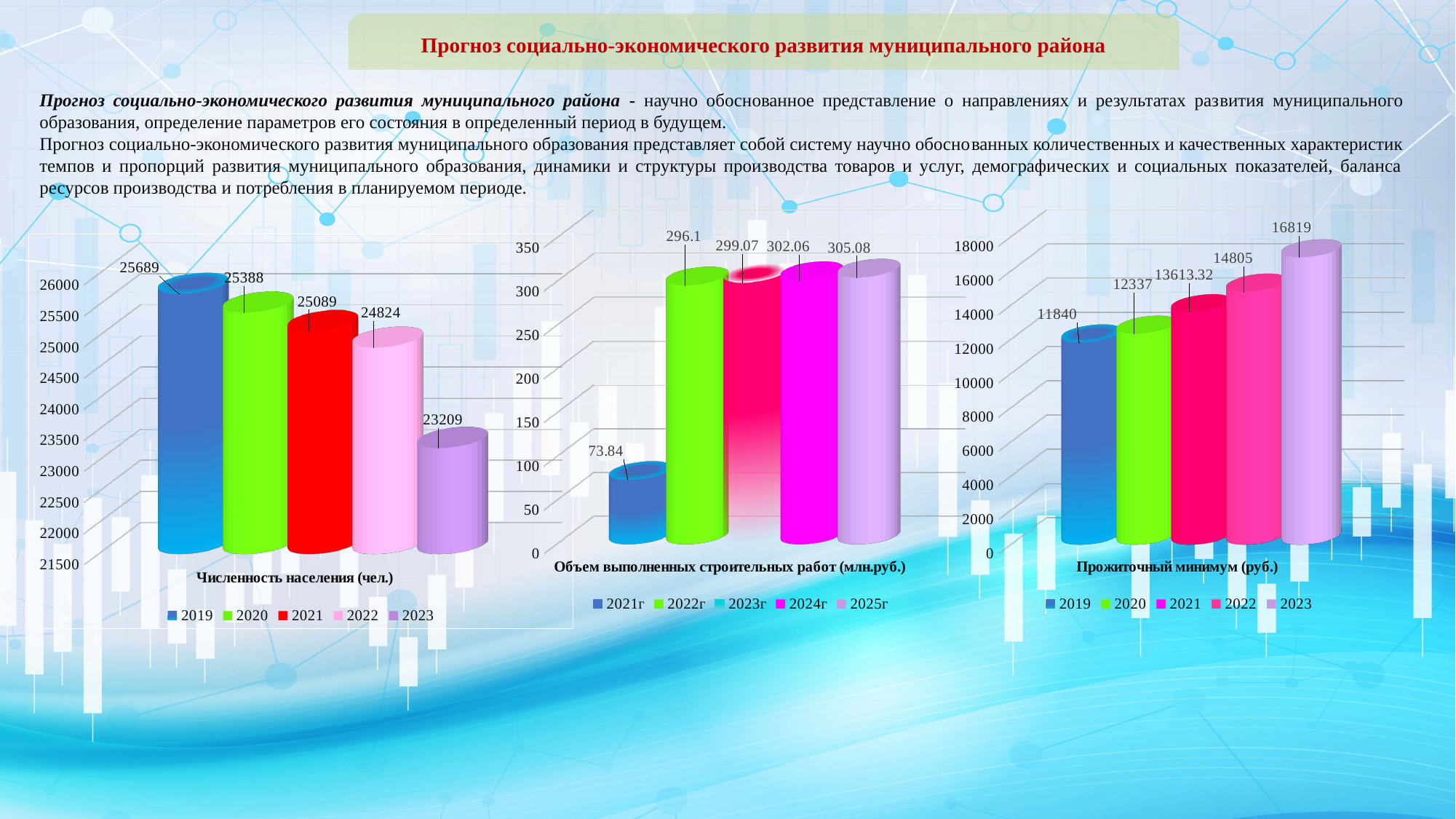
In the chart titled "Объем выполненных строительных работ (млн.руб.)", which year has the highest value? 2025г In the chart titled "Численность населения (чел.)", do the values rise or fall from 2019 to 2023? fall In the chart titled "Объем выполненных строительных работ (млн.руб.)", how many series does the legend list? 5 In the chart titled "Прожиточный минимум (руб.)", which is larger, the value for 2020 or the value for 2022? 2022 In the chart titled "Прожиточный минимум (руб.)", what is the value for 2021? 13613.32 What kind of chart is the chart titled "Прожиточный минимум (руб.)"? bar chart In the chart titled "Численность населения (чел.)", which year has the lowest value? 2023 In the chart titled "Объем выполненных строительных работ (млн.руб.)", is the value for 2022г greater or less than 250? greater In the chart titled "Прожиточный минимум (руб.)", what is the difference between the 2023 and 2019 values? 4979 In the chart titled "Численность населения (чел.)", what is the value for 2019? 25689 In the chart titled "Численность населения (чел.)", what is the difference between the 2019 and 2023 values? 2480 In the chart titled "Объем выполненных строительных работ (млн.руб.)", what is the value for 2021г? 73.84